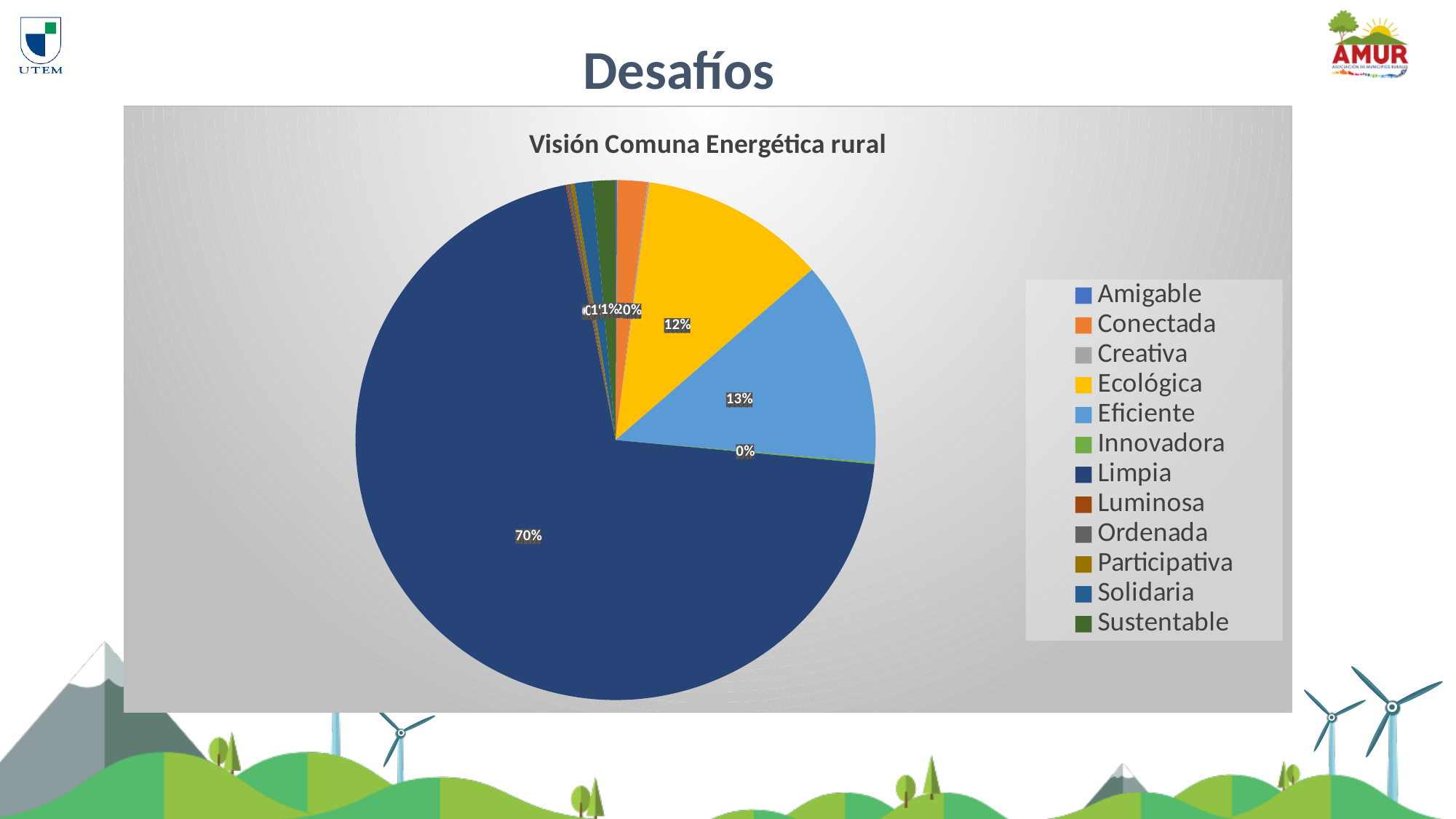
What colour is the slice for Ecológica? yellow What percentage of the pie does Limpia account for? 70% What is the difference in percentage points between Limpia and Eficiente? 57% What is the title of the chart? Visión Comuna Energética rural What is the value shown for Eficiente? 13% What kind of chart is shown on the slide? pie chart How many categories does the legend of the pie chart list? 12 What is the value shown for Ecológica? 12% What is the value shown for Innovadora? 0% Which category has the largest slice of the pie? Limpia Which is larger, the slice for Eficiente or the slice for Ecológica? Eficiente Is the share for Limpia greater or less than 50%? greater